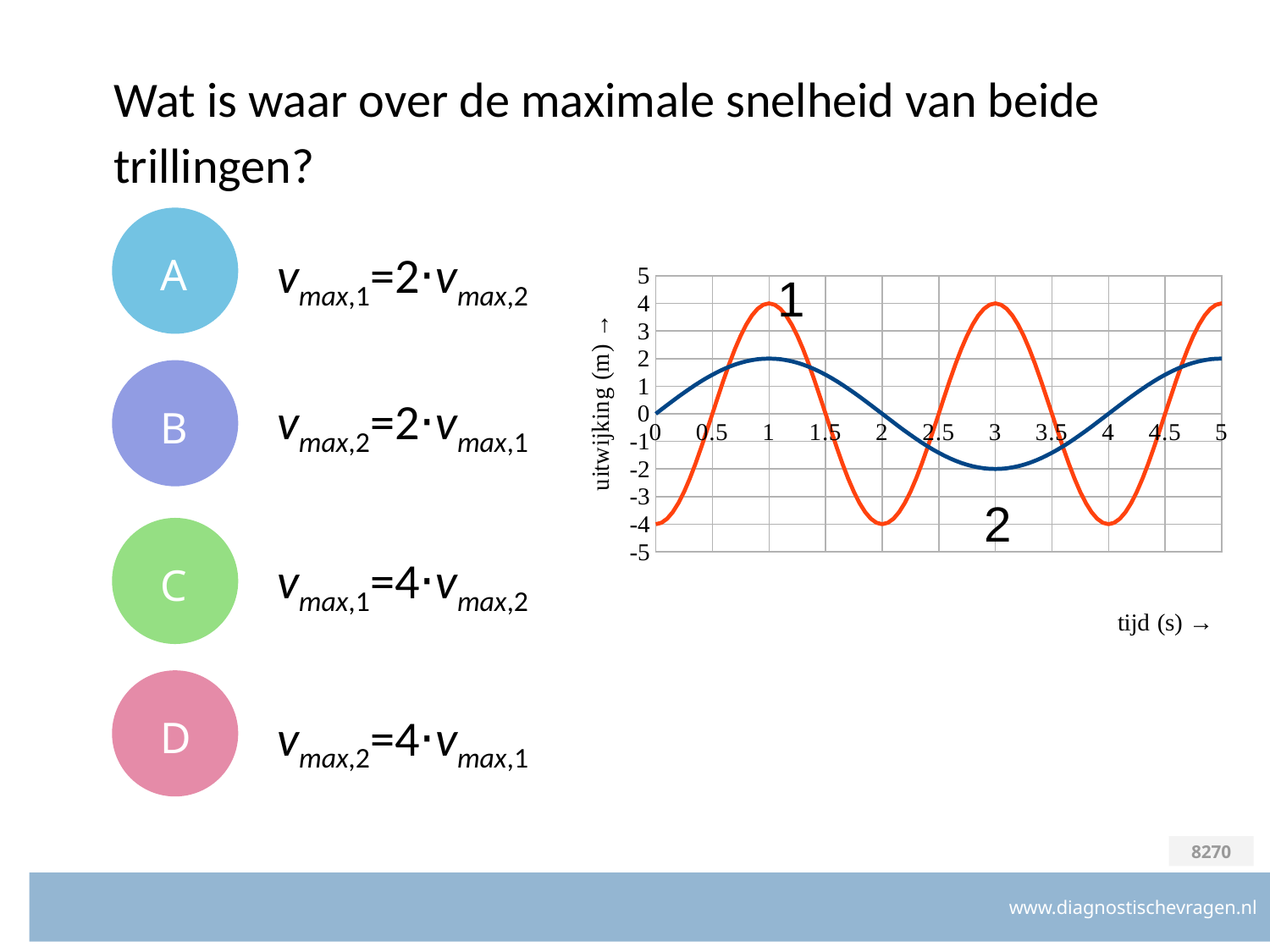
What is the minimum value reached by curve 1? -4 Which curve reaches the higher maximum value, curve 1 or curve 2? curve 1 What is the value of curve 2 at tijd = 3 s? -2 What is the label of the vertical axis of the chart? uitwijking (m) How many curves are plotted on the chart? 2 What is the label of the horizontal axis of the chart? tijd (s) What is the minimum value reached by curve 2? -2 What is the maximum value reached by curve 2? 2 What is the maximum value reached by curve 1? 4 What kind of chart is shown on the slide? line chart What is the value of curve 1 at tijd = 0 s? -4